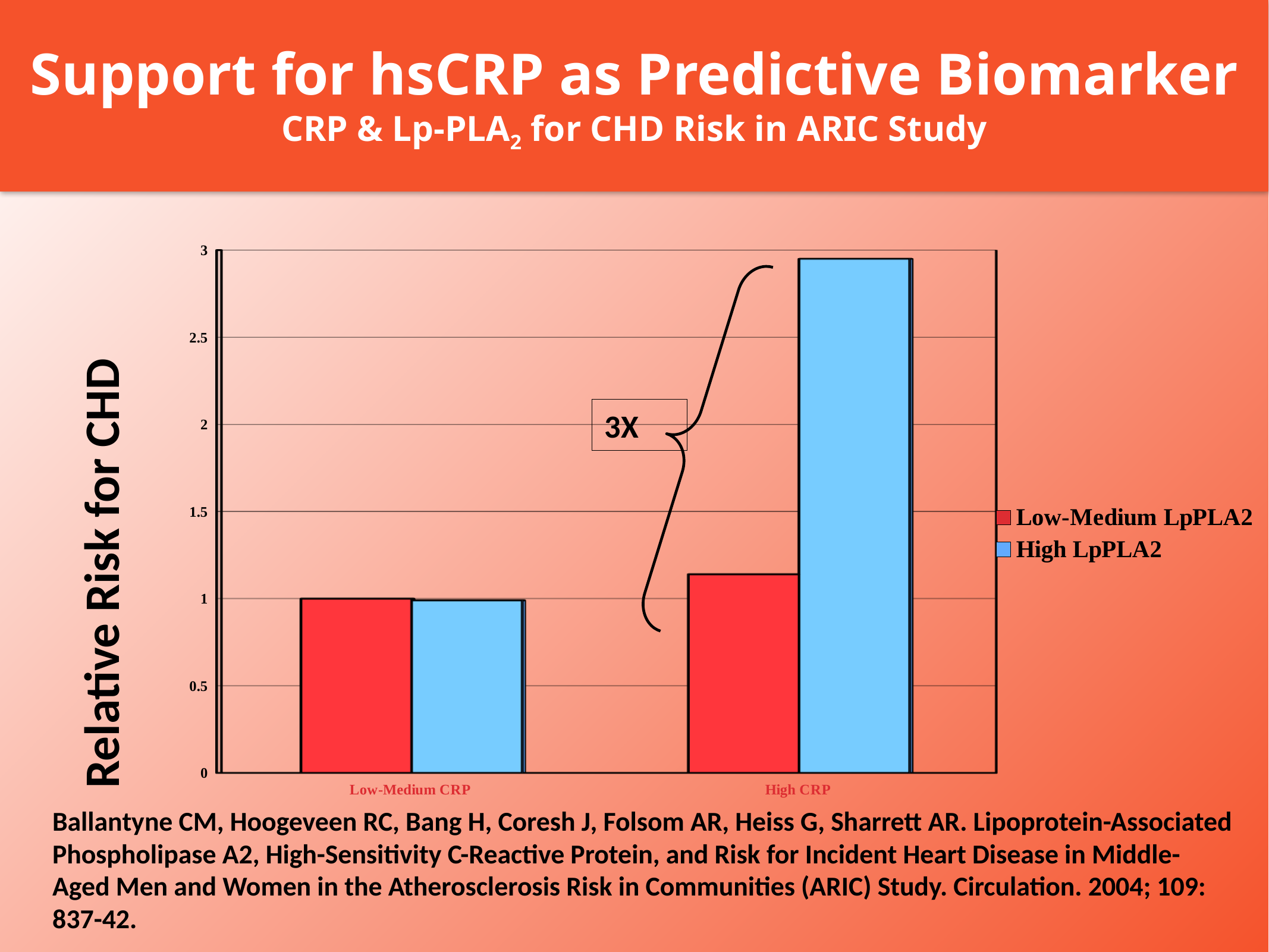
How many series does the chart's legend list? 2 What is the title of the chart's y axis? Relative Risk for CHD Which bar in the chart is the highest? High LpPLA2 for High CRP Is the value for High LpPLA2 in the Low-Medium CRP category greater or less than 1.5? less What kind of chart is shown on the slide? bar chart In the High CRP category, which series has the larger value, Low-Medium LpPLA2 or High LpPLA2? High LpPLA2 How many categories are shown on the x axis of the chart? 2 Is the value for High LpPLA2 in the High CRP category greater or less than 2.5? greater Does the High LpPLA2 series rise or fall from Low-Medium CRP to High CRP? rise For the Low-Medium LpPLA2 series, which category has the larger value, Low-Medium CRP or High CRP? High CRP What colour represents the High LpPLA2 series in the chart? blue Is the value for Low-Medium LpPLA2 in the High CRP category greater or less than 1.5? less